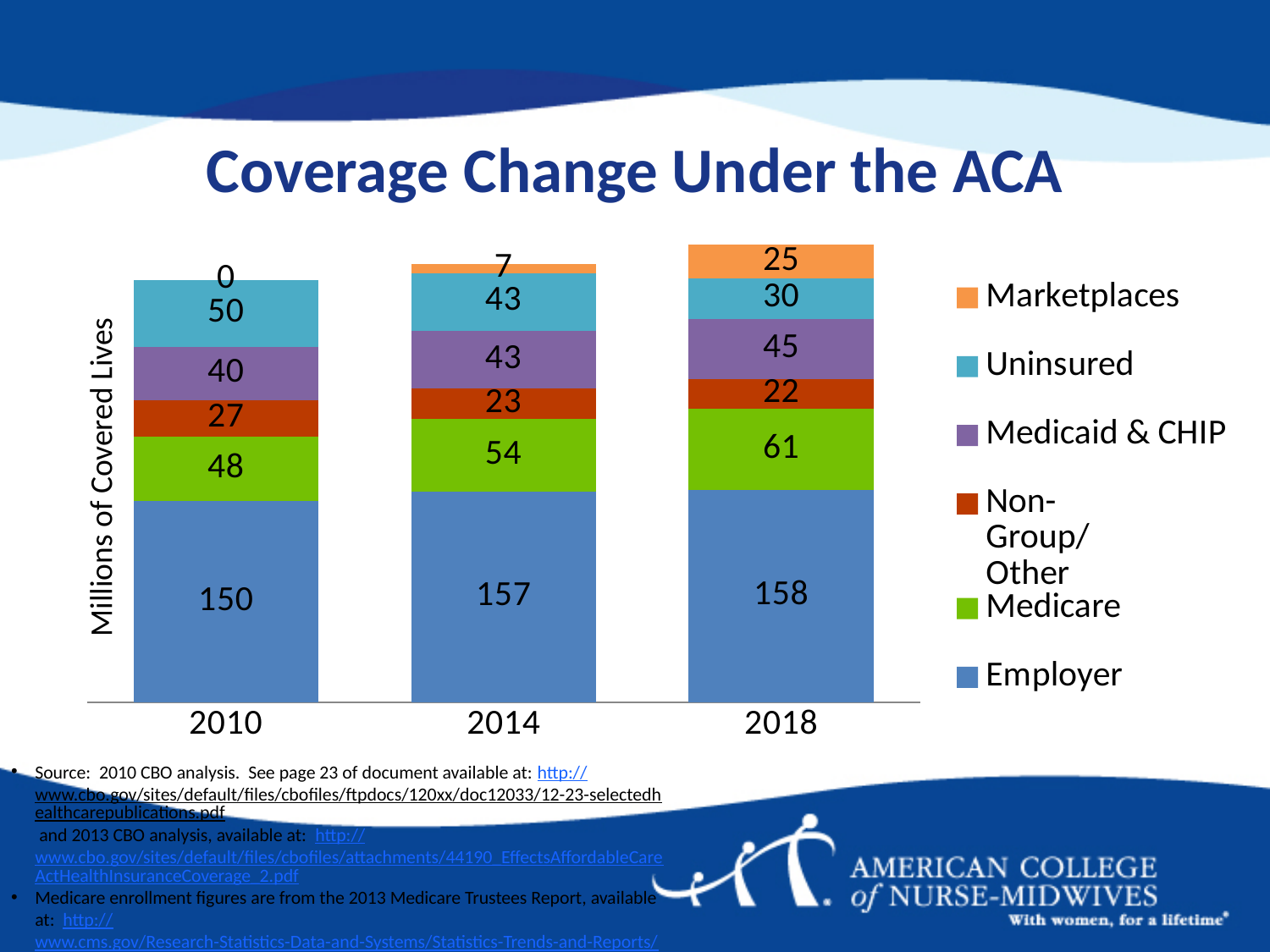
What is the Marketplaces value for 2010? 0 What is the total of the stacked bar for 2010? 315 In which year is the Medicare value highest? 2018 Which is larger, the Medicaid & CHIP value for 2010 or for 2014? 2014 What is the Employer value for 2014? 157 Does the Non-Group/Other value rise or fall from 2010 to 2018? Fall How many series does the legend list? 6 What is the difference between the Marketplaces values for 2018 and 2014? 18 What type of chart is shown on the slide? Stacked bar chart What is the Uninsured value for 2018? 30 In which year is the Uninsured value lowest? 2018 How many years are shown on the x axis? 3